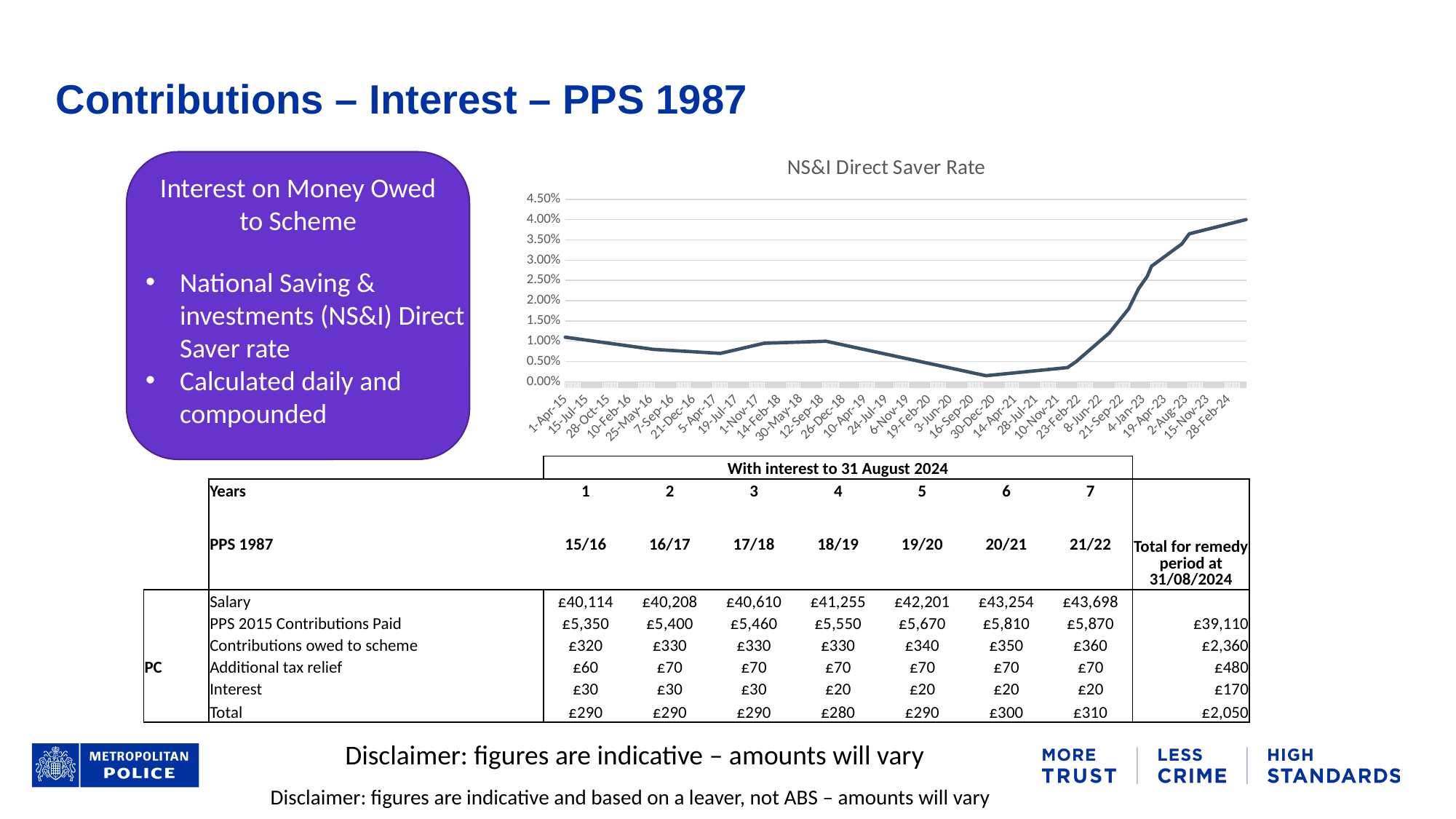
What is the highest value shown on the y axis of the NS&I Direct Saver Rate chart? 4.50% In the NS&I Direct Saver Rate chart, is the value at 30-Dec-20 greater or less than 0.50%? less In the NS&I Direct Saver Rate chart, does the rate rise or fall between 30-Dec-20 and 28-Feb-24? rise In the NS&I Direct Saver Rate chart, is the value at 10-Nov-21 greater or less than 1.00%? less Around which date on the x axis is the NS&I Direct Saver Rate at its lowest? 30-Dec-20 In the NS&I Direct Saver Rate chart, which is higher: the value at 1-Apr-15 or the value at 28-Feb-24? 28-Feb-24 What is the title of the chart on the slide? NS&I Direct Saver Rate In the NS&I Direct Saver Rate chart, is the value at 1-Apr-15 greater or less than 0.50%? greater What kind of chart is the NS&I Direct Saver Rate chart? line chart